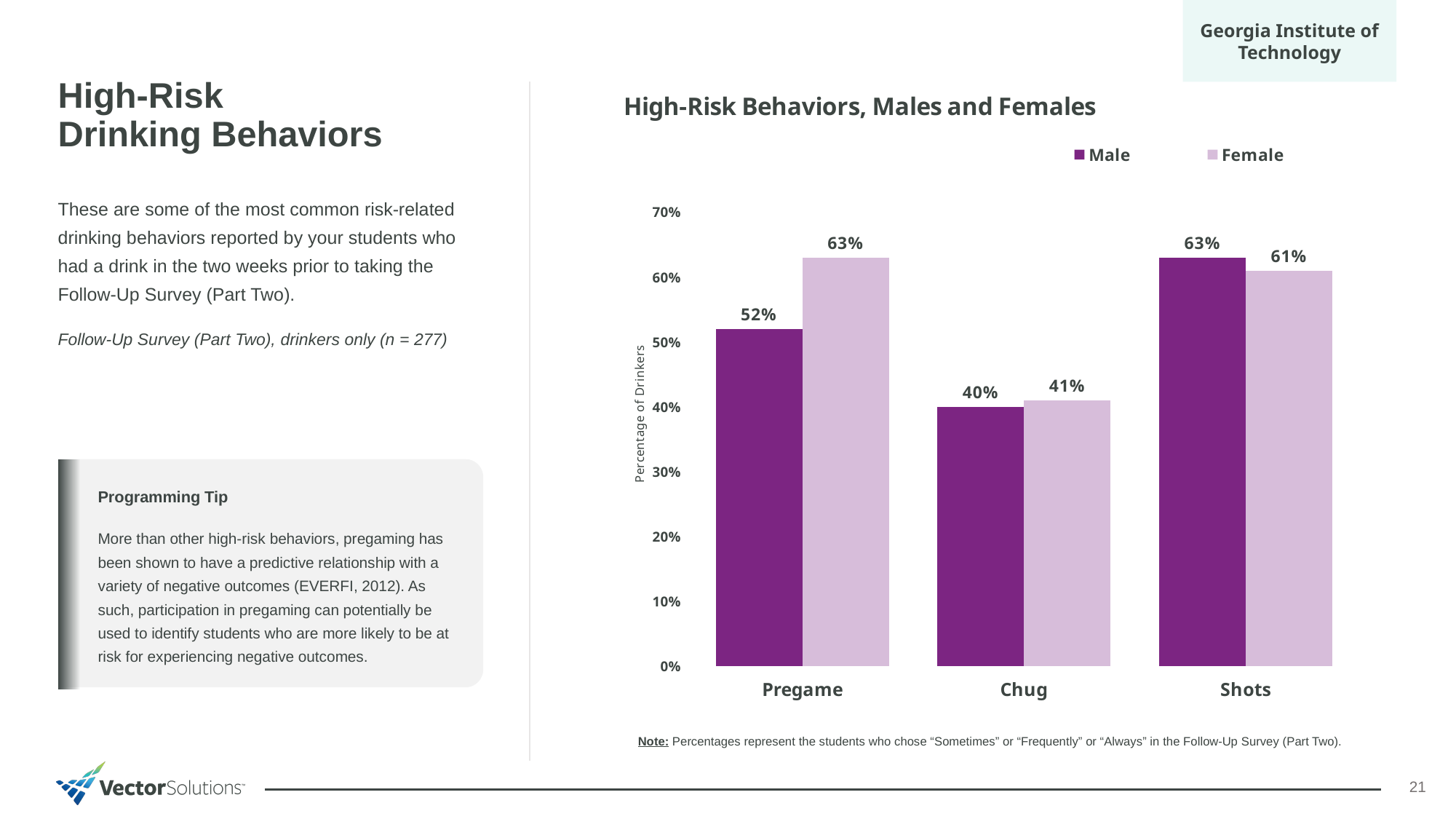
What is the Female value for Shots? 61% Which category has the highest Female value? Pregame What is the label on the y axis? Percentage of Drinkers What is the title of the chart? High-Risk Behaviors, Males and Females How many categories are shown on the x axis? 3 What is the Male value for Chug? 40% Which is larger for Shots, the Male value or the Female value? Male What is the Male value for Pregame? 52% How many series does the legend list? 2 Which category has the lowest Male value? Chug What kind of chart is shown? Bar chart What is the difference between the Female and Male values for Pregame? 11%